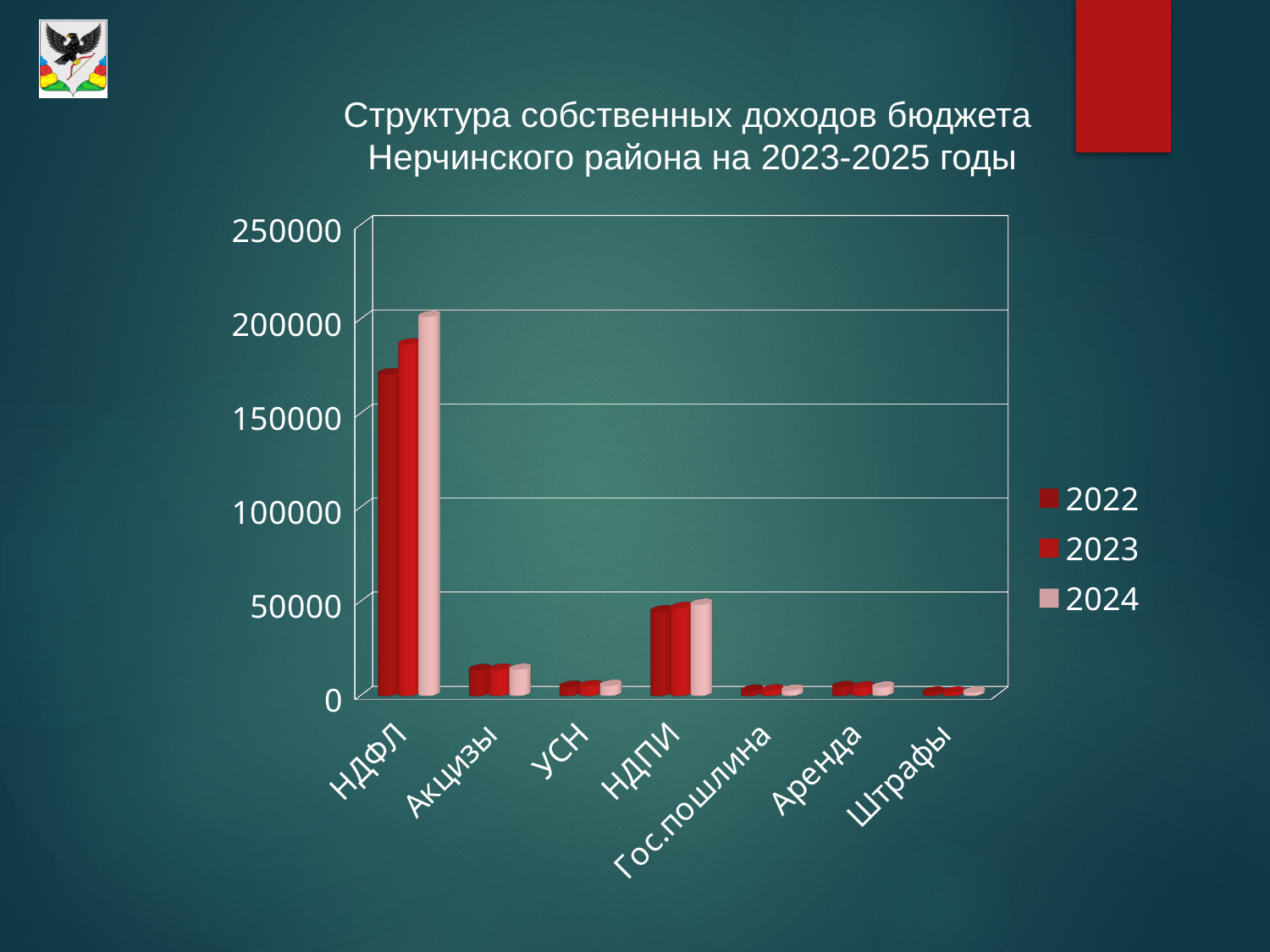
Is the value for НДПИ in 2023 greater or less than 100000? less Which is larger, the value for НДФЛ in 2023 or the value for НДПИ in 2023? НДФЛ in 2023 Which category has the highest values in the chart? НДФЛ What kind of chart is shown on the slide? bar chart What is the title of the chart? Структура собственных доходов бюджета Нерчинского района на 2023-2025 годы How many categories are shown on the x axis of the chart? 7 Which series is shown in light pink in the legend? 2024 Is the value for НДФЛ in 2022 greater or less than 150000? greater Is the value for Акцизы in 2024 greater or less than 50000? less Do the values for НДФЛ rise or fall from 2022 to 2024? rise How many series does the legend list? 3